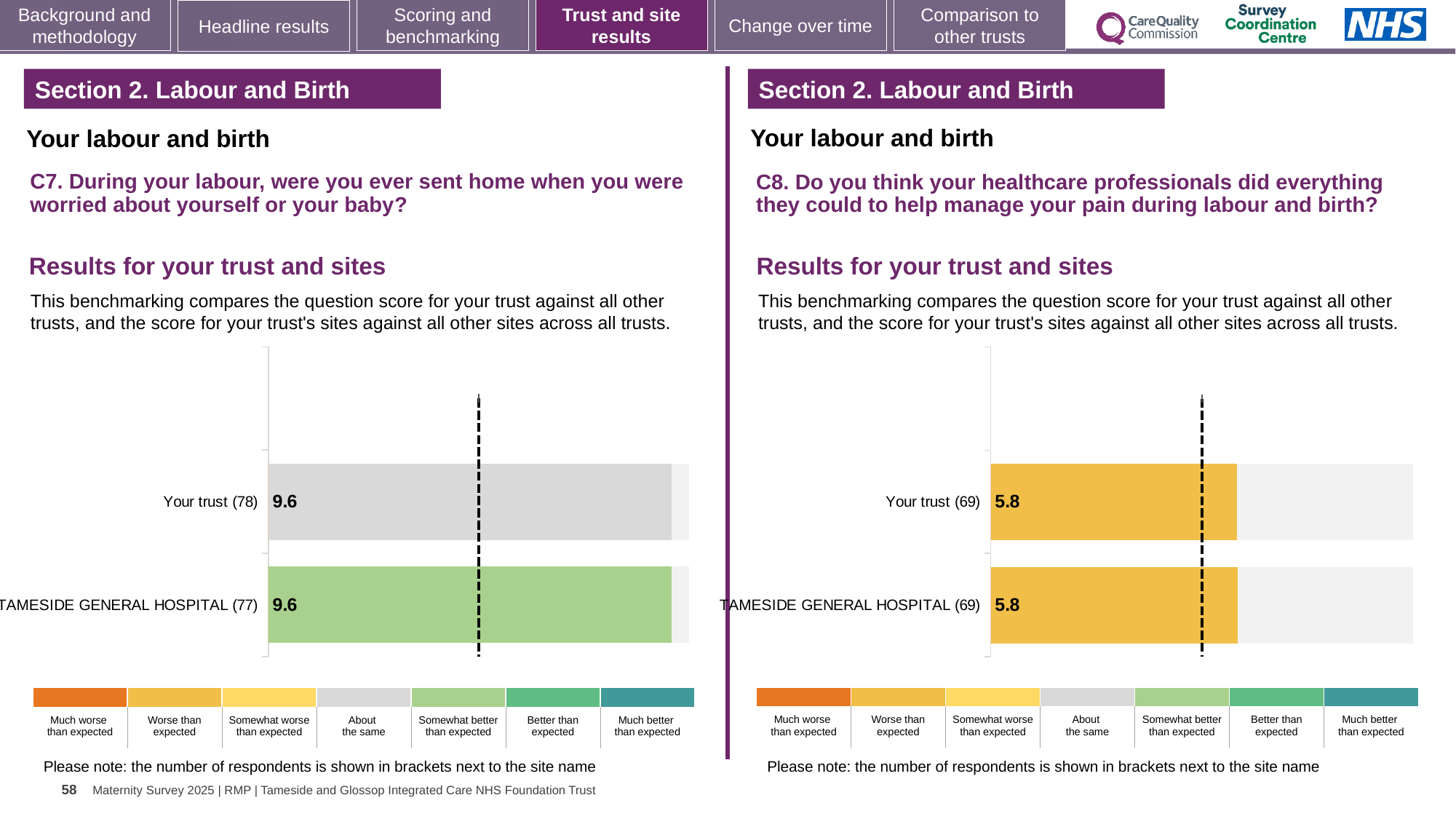
In the C8 chart on the right, what is the score for TAMESIDE GENERAL HOSPITAL? 5.8 What kind of chart is used for the C7 results on the left? Bar chart In the C7 chart on the left, how many respondents are shown in brackets for Your trust? 78 How many bars are plotted in the C7 chart on the left? 2 How many bars are plotted in the C8 chart on the right? 2 In the C7 chart on the left, what is the score for Your trust? 9.6 In the C7 chart on the left, which benchmark category does the colour of the TAMESIDE GENERAL HOSPITAL bar correspond to? Somewhat better than expected In the C8 chart on the right, what is the difference between the score for Your trust and the score for TAMESIDE GENERAL HOSPITAL? 0 In the C8 chart on the right, how many respondents are shown in brackets for TAMESIDE GENERAL HOSPITAL? 69 In the C7 chart on the left, what is the difference between the score for Your trust and the score for TAMESIDE GENERAL HOSPITAL? 0 In the C7 chart on the left, what is the score for TAMESIDE GENERAL HOSPITAL? 9.6 In the C8 chart on the right, what is the score for Your trust? 5.8